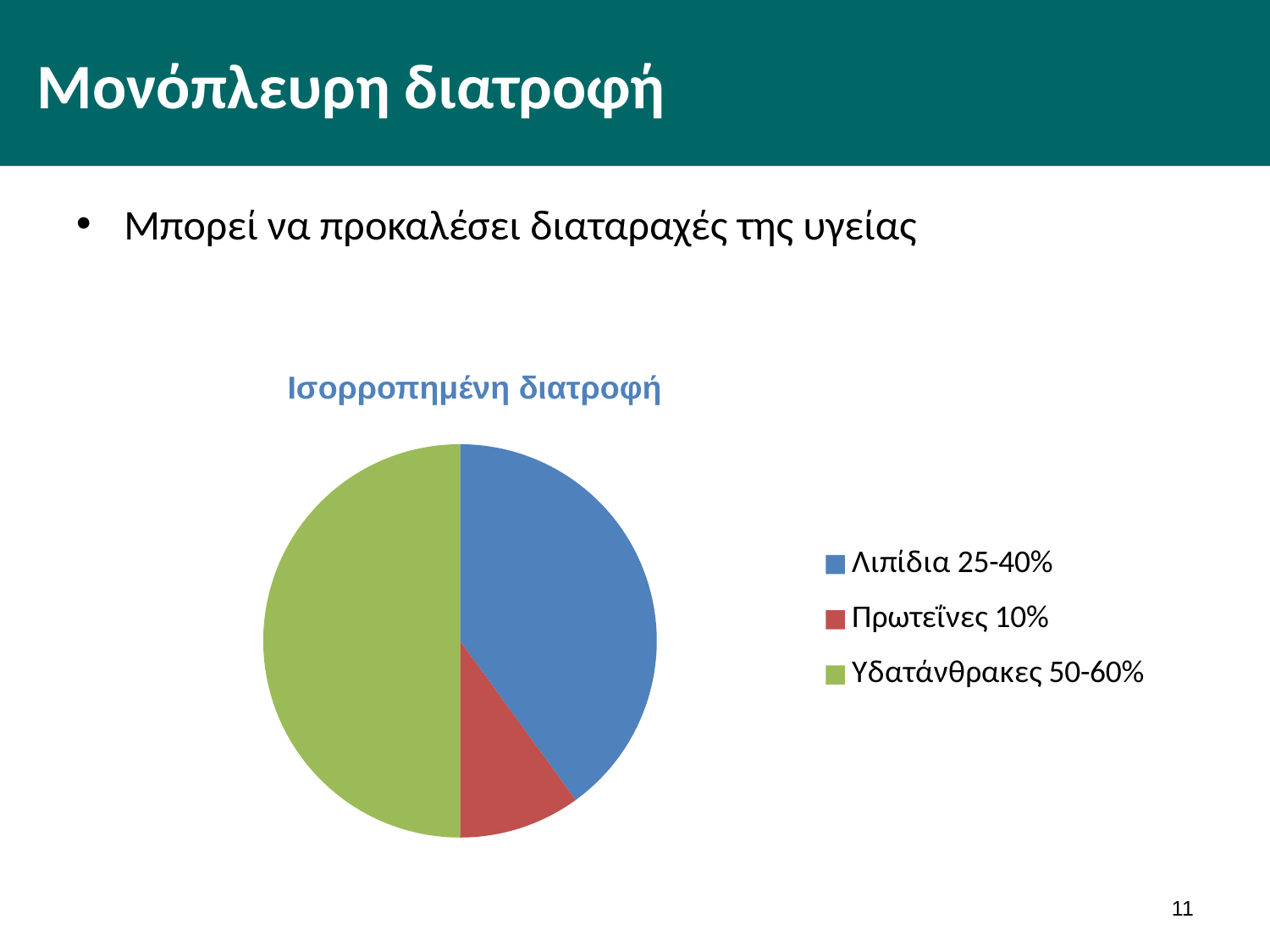
Which category has the smallest slice in the pie chart? Πρωτεΐνες What percentage range does the legend give for Λιπίδια? 25-40% Which slice is larger, Υδατάνθρακες or Λιπίδια? Υδατάνθρακες Which slice is larger, Λιπίδια or Πρωτεΐνες? Λιπίδια What kind of chart is shown on the slide? Pie chart Which category has the largest slice in the pie chart? Υδατάνθρακες What is the title of the pie chart? Ισορροπημένη διατροφή What percentage does the legend give for Πρωτεΐνες? 10% How many entries does the legend of the pie chart list? 3 How many slices does the pie chart have? 3 What percentage range does the legend give for Υδατάνθρακες? 50-60% What colour is the Πρωτεΐνες slice in the pie chart? Red